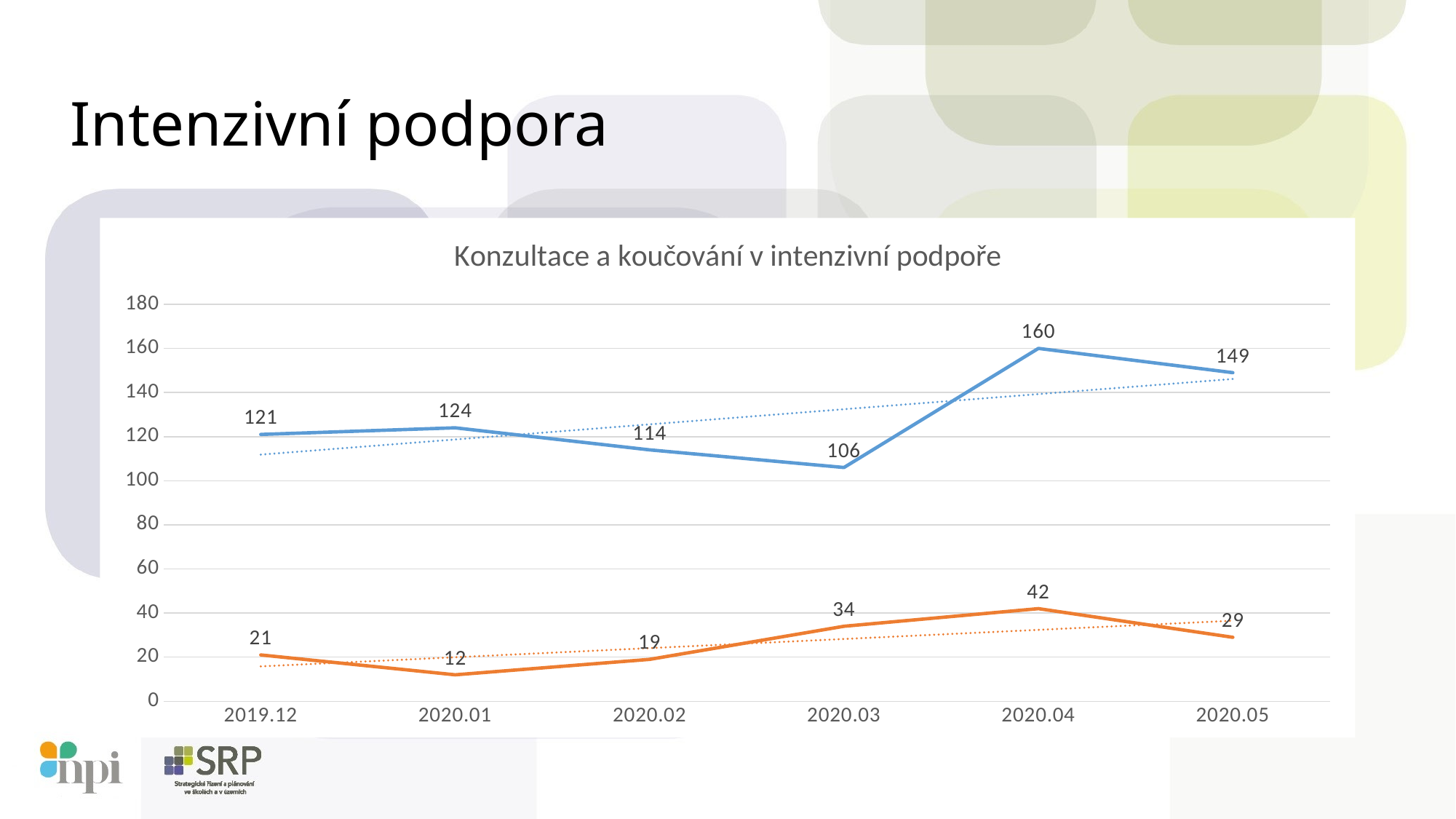
What is the value of the blue line at 2019.12? 121 Is the value of the blue line at 2020.05 greater or less than 140? greater What is the value of the blue line at 2020.04? 160 What is the value of the orange line at 2020.01? 12 Which is larger: the orange line's value at 2020.03 or at 2020.05? 2020.03 Does the orange line rise or fall from 2020.01 to 2020.04? rise At which month does the orange line have its lowest value? 2020.01 How many months are shown on the x axis? 6 At which month does the blue line reach its highest value? 2020.04 What is the difference between the blue line's values at 2020.04 and 2020.03? 54 What is the title of the chart? Konzultace a koučování v intenzivní podpoře What kind of chart is shown on the slide? line chart